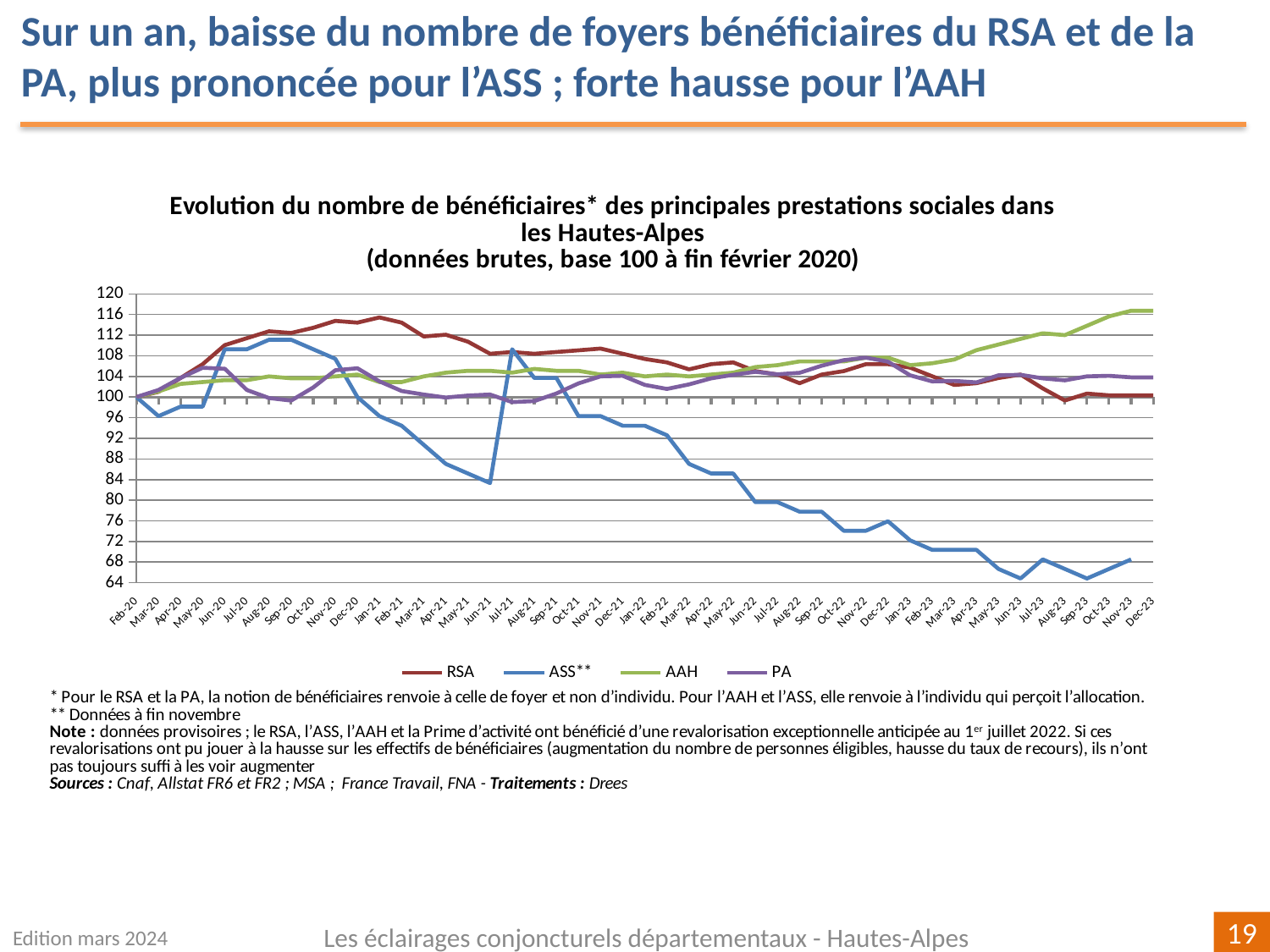
What kind of chart is shown on the slide? line chart Which series has the lowest value at Dec-23? RSA What is the value of each series at Feb-20, the base month? 100 Which series are listed in the legend? RSA, ASS**, AAH, PA Is the value for ASS** at Jun-21 greater or less than 88? less Is the value for RSA at Jan-21 greater or less than 112? greater Which series has the highest value at Dec-23? AAH How many series does the legend list? 4 Does the AAH series rise or fall overall from Feb-20 to Dec-23? rise Is the value for AAH at Dec-23 greater or less than 112? greater